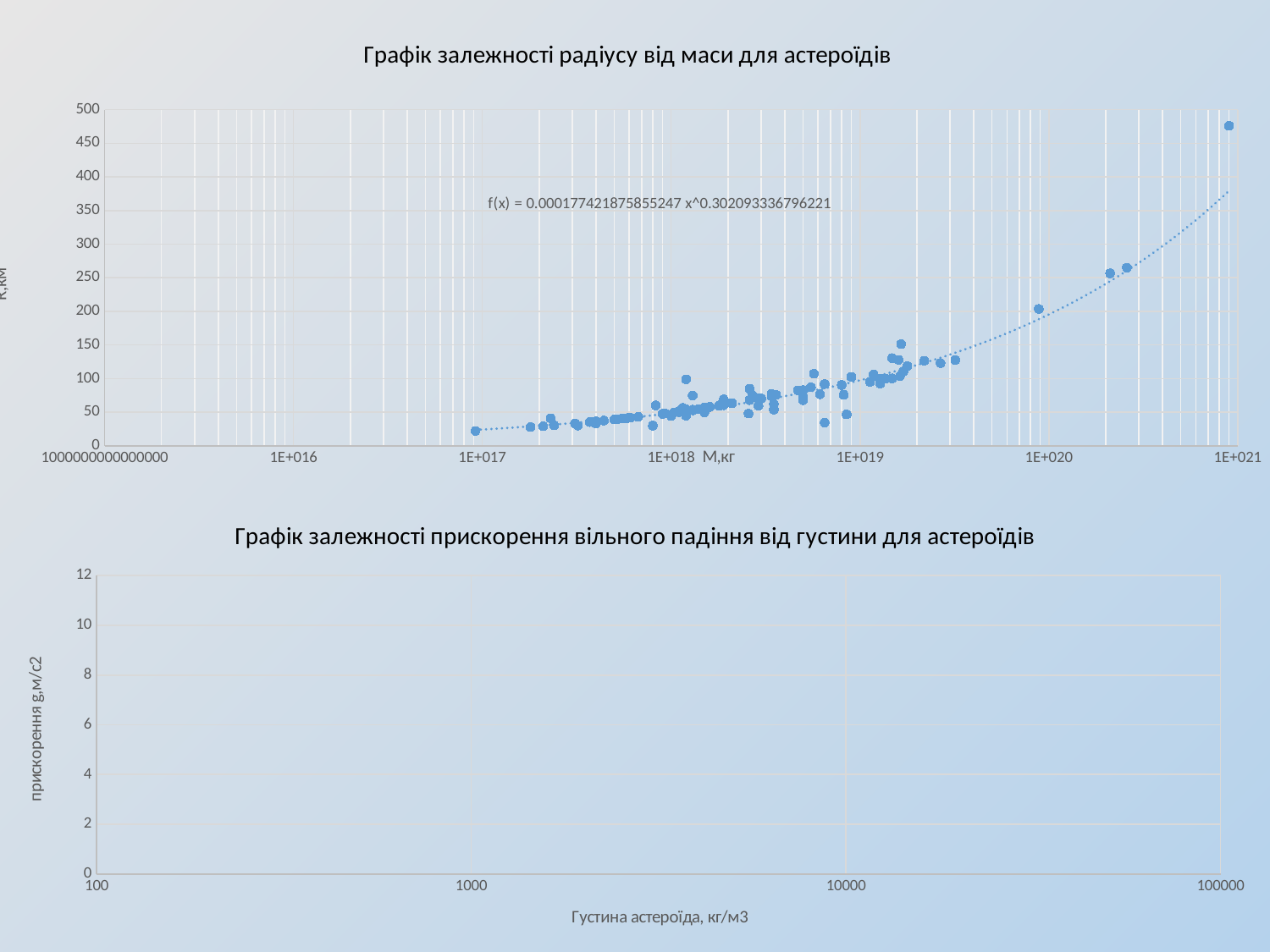
In the top chart 'Графік залежності радіусу від маси для астероїдів', is the radius of the lowest point (near 1E+017 kg) greater or less than 50? less In the top chart 'Графік залежності радіусу від маси для астероїдів', is the radius of the point near 1E+020 kg greater or less than 150? greater In the top chart 'Графік залежності радіусу від маси для астероїдів', is the radius of the highest point (near 1E+021 kg) greater or less than 450? greater What kind of chart is the top chart, 'Графік залежності радіусу від маси для астероїдів'? scatter chart What is the x-axis label of the bottom chart 'Графік залежності прискорення вільного падіння від густини для астероїдів'? Густина астероїда, кг/м3 In the top chart 'Графік залежності радіусу від маси для астероїдів', do the radius values rise or fall as mass increases along the x axis? rise In the top chart 'Графік залежності радіусу від маси для астероїдів', what is the trendline equation shown on the chart? f(x) = 0.000177421875855247 x^0.302093336796221